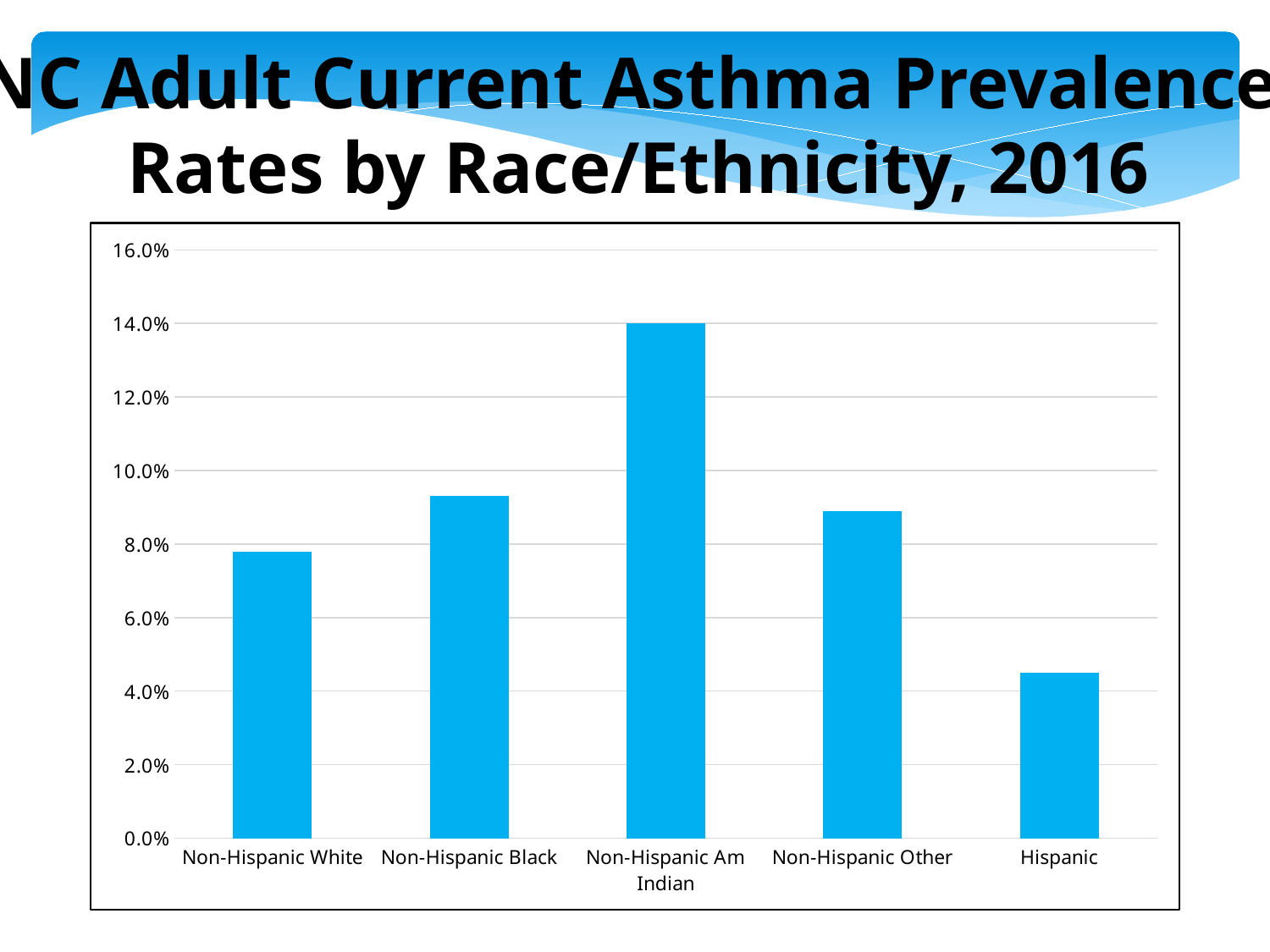
Which has a higher asthma prevalence rate, Non-Hispanic Am Indian or Non-Hispanic Other? Non-Hispanic Am Indian Is the value for Hispanic greater or less than 6.0%? less Is the value for Non-Hispanic Black greater or less than 10.0%? less Is the value for Non-Hispanic White greater or less than 6.0%? greater Which has a higher asthma prevalence rate, Non-Hispanic Black or Non-Hispanic White? Non-Hispanic Black Which race/ethnicity category has the lowest adult current asthma prevalence rate? Hispanic What kind of chart is shown on the slide? bar chart How many race/ethnicity categories are plotted in the chart? 5 What is the title of the slide containing the chart? NC Adult Current Asthma Prevalence Rates by Race/Ethnicity, 2016 Which race/ethnicity category has the highest adult current asthma prevalence rate? Non-Hispanic Am Indian